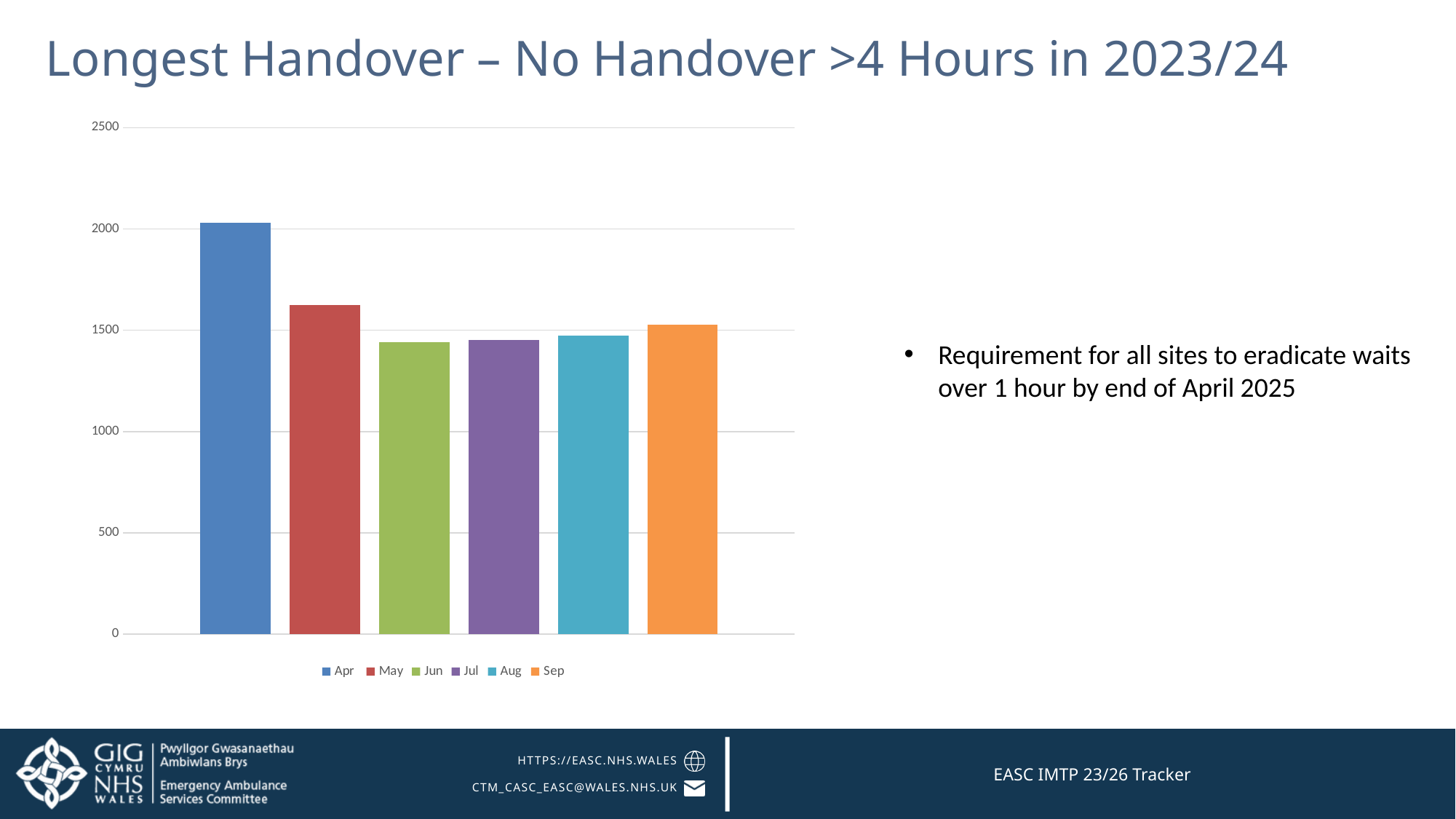
Which is larger, the value for Apr or the value for May? Apr Which is larger, the value for May or the value for Sep? May Is the value for Jun greater or less than 1500? less Is the value for Apr greater or less than 2000? greater What kind of chart is shown on the slide? Bar chart How many bars are plotted in the chart? 6 Which month has the highest bar? Apr Is the value for May greater or less than 2000? less How many entries does the legend list? 6 Do the values rise or fall from Apr to Jun? fall What colour is the bar for Sep? Orange